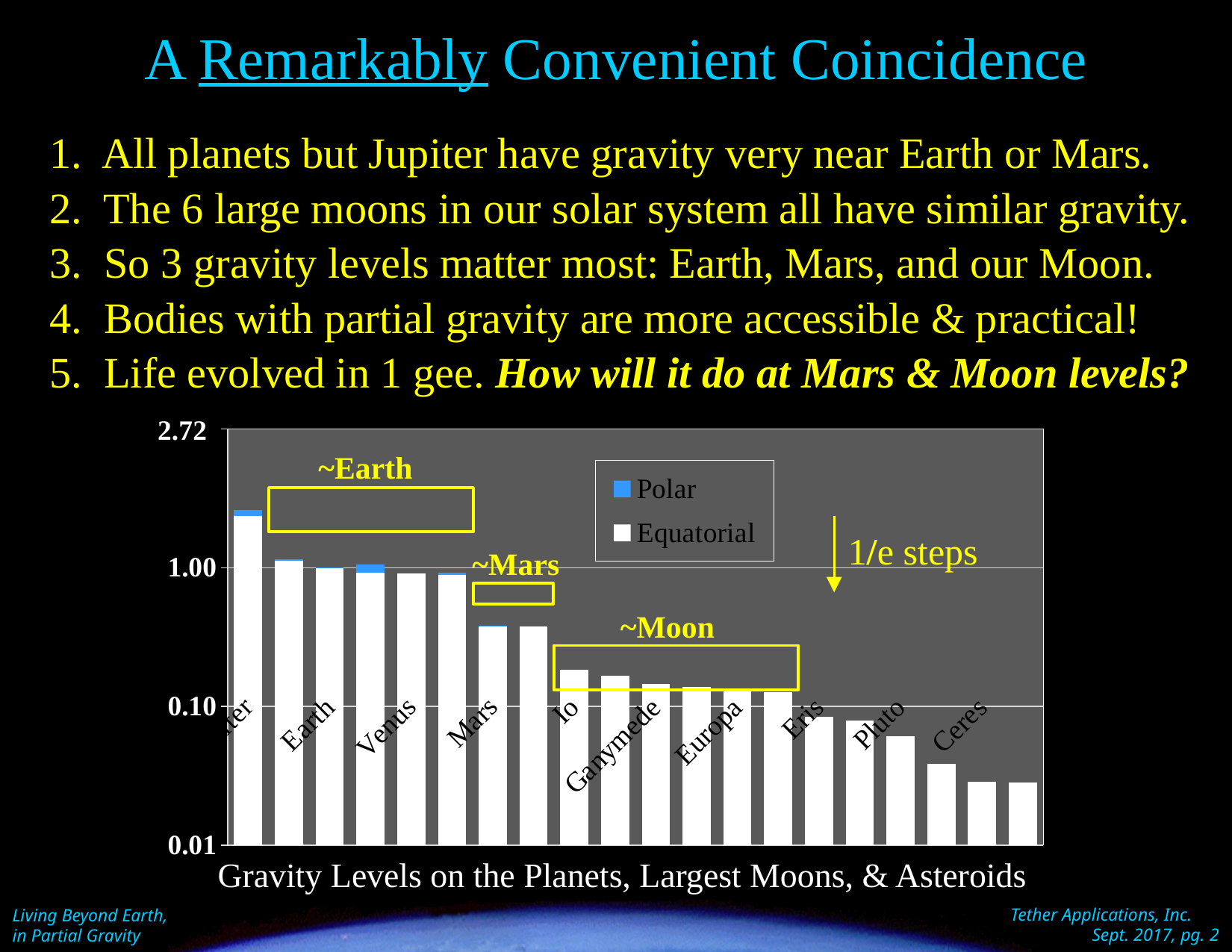
What is the title of the chart? Gravity Levels on the Planets, Largest Moons, & Asteroids Which has the larger value, Earth or Mars? Earth What are the two series named in the legend? Polar and Equatorial Is the value for Mars greater or less than 0.10? greater What kind of chart is shown on the slide? bar chart How many bars are plotted in the chart? 20 Do the bar values rise or fall from left to right along the x axis? fall Which has the larger value, Mars or Io? Mars Is the value for Ceres greater or less than 0.10? less Is the value for Mars greater or less than 1.00? less How many series does the chart legend list? 2